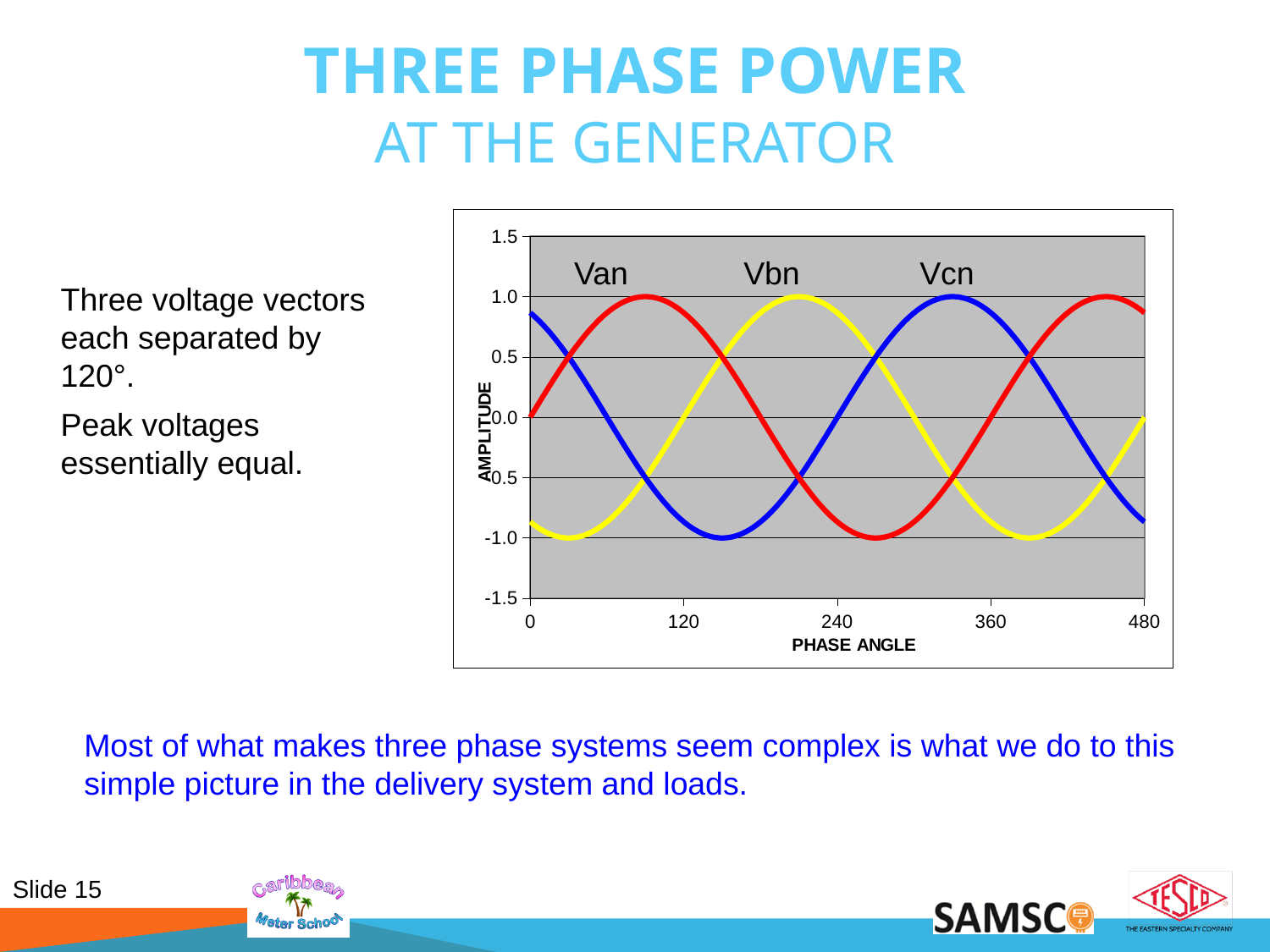
Is the value for Vbn at a phase angle of 0 greater or less than -0.5? less Between phase angles 120 and 240, does Van rise or fall? fall What colour is the Vcn curve? blue What is the peak amplitude reached by Van? 1.0 What is the amplitude of Van at a phase angle of 0? 0.0 What kind of chart is shown on the slide? line chart At a phase angle of 0, which is larger, Vcn or Vbn? Vcn What is the amplitude of Vcn at a phase angle of 240? 0.0 What is the amplitude of Vbn at a phase angle of 120? 0.0 Is the value for Van at a phase angle of 120 greater or less than 0.5? greater What is the lowest amplitude reached by Vcn? -1.0 How many voltage series are plotted on the chart? 3